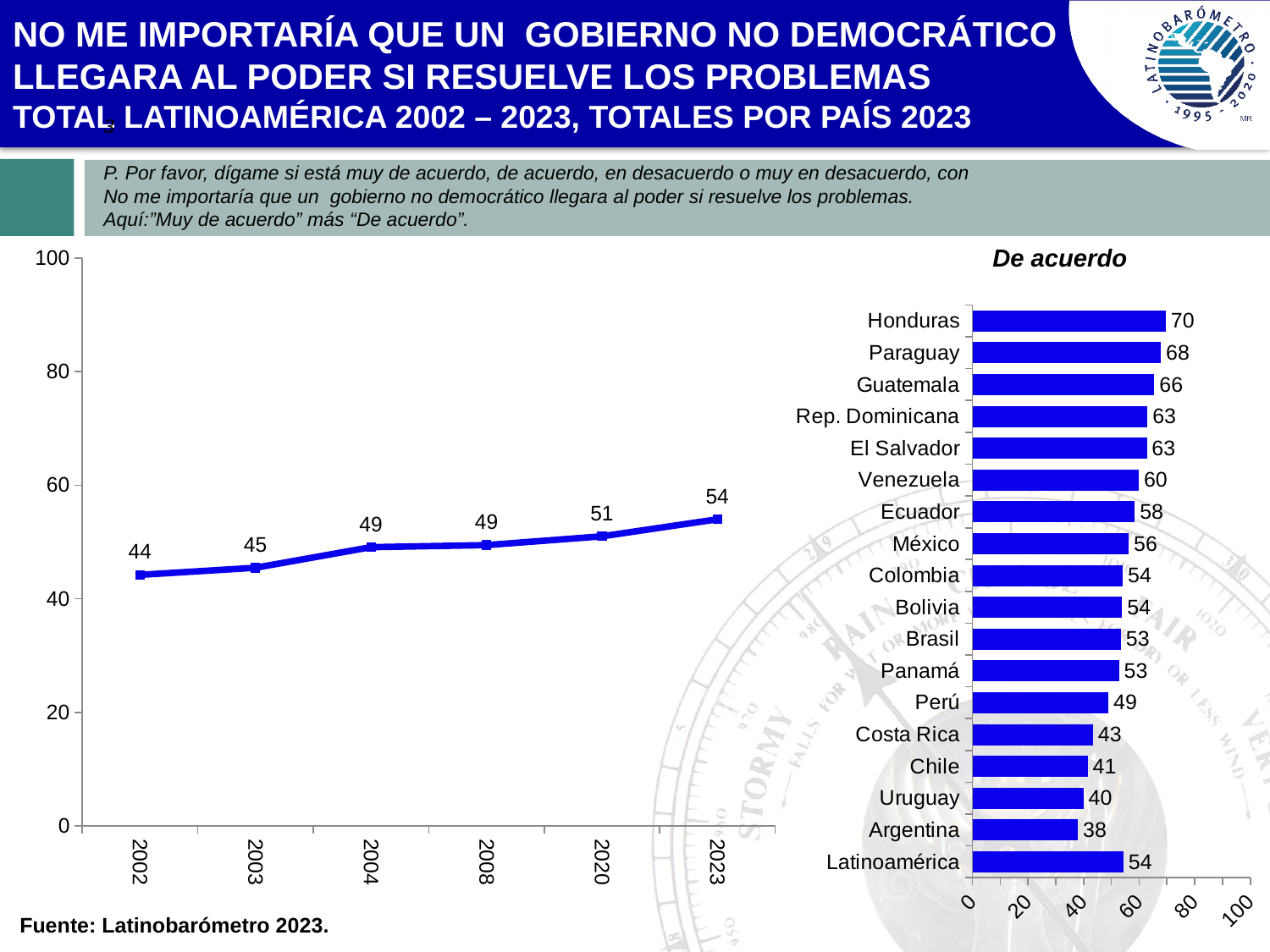
In the bar chart titled 'De acuerdo', what is the value for Latinoamérica? 54 In the bar chart titled 'De acuerdo', which is larger, the value for Paraguay or the value for Chile? Paraguay What kind of chart is the chart on the right of the slide? bar chart In the line chart on the left, which year has the highest value? 2023 In the bar chart titled 'De acuerdo', what is the value for Honduras? 70 In the line chart on the left, what is the value for 2023? 54 In the bar chart titled 'De acuerdo', what is the difference between the values for Honduras and Argentina? 32 In the line chart on the left, do the values rise or fall from 2002 to 2023? rise In the line chart on the left, what is the value for 2002? 44 In the line chart on the left, how many years are plotted? 6 In the line chart on the left, what is the difference between the 2023 value and the 2002 value? 10 In the bar chart titled 'De acuerdo', which country has the lowest value? Argentina